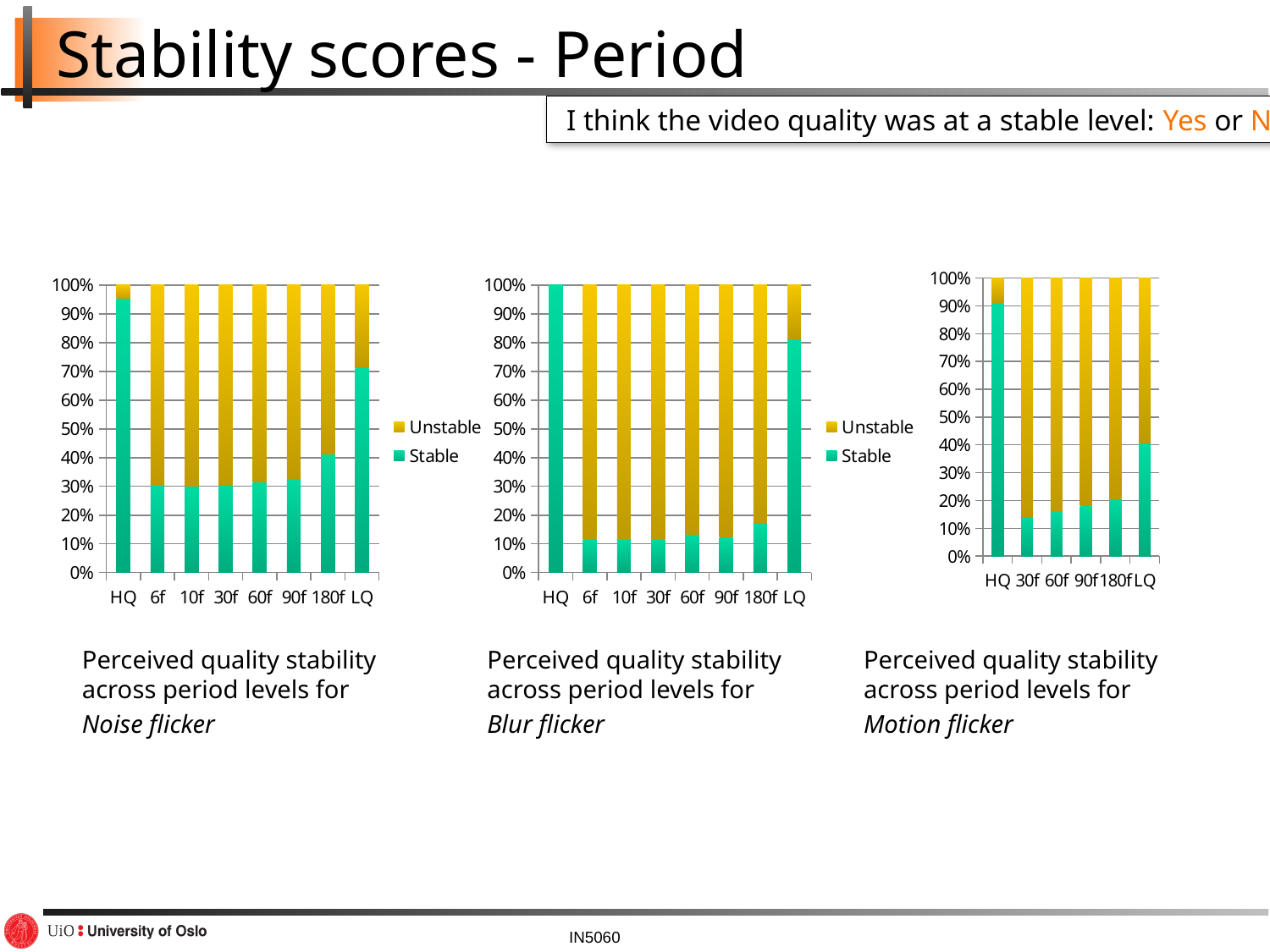
How many period categories are shown on the x axis of the Blur flicker chart in the middle? 8 What kind of chart is used for the Noise flicker chart on the left? Stacked bar chart In the Blur flicker chart, which has the larger Stable share, HQ or LQ? HQ In the Motion flicker chart, is the Stable share for LQ greater or less than 50%? less In the Blur flicker chart, which category has the largest Stable share? HQ How many series does the legend of the Noise flicker chart list? 2 How many categories are shown on the x axis of the Motion flicker chart on the right? 6 In the Blur flicker chart, is the Stable share for 6f greater or less than 20%? less In the Noise flicker chart, is the Stable share for LQ greater or less than 60%? greater In the Noise flicker chart, which category has the largest Stable share? HQ In the Motion flicker chart, which category has the largest Stable share? HQ What are the two legend entries shown for the Noise flicker and Blur flicker charts? Unstable and Stable